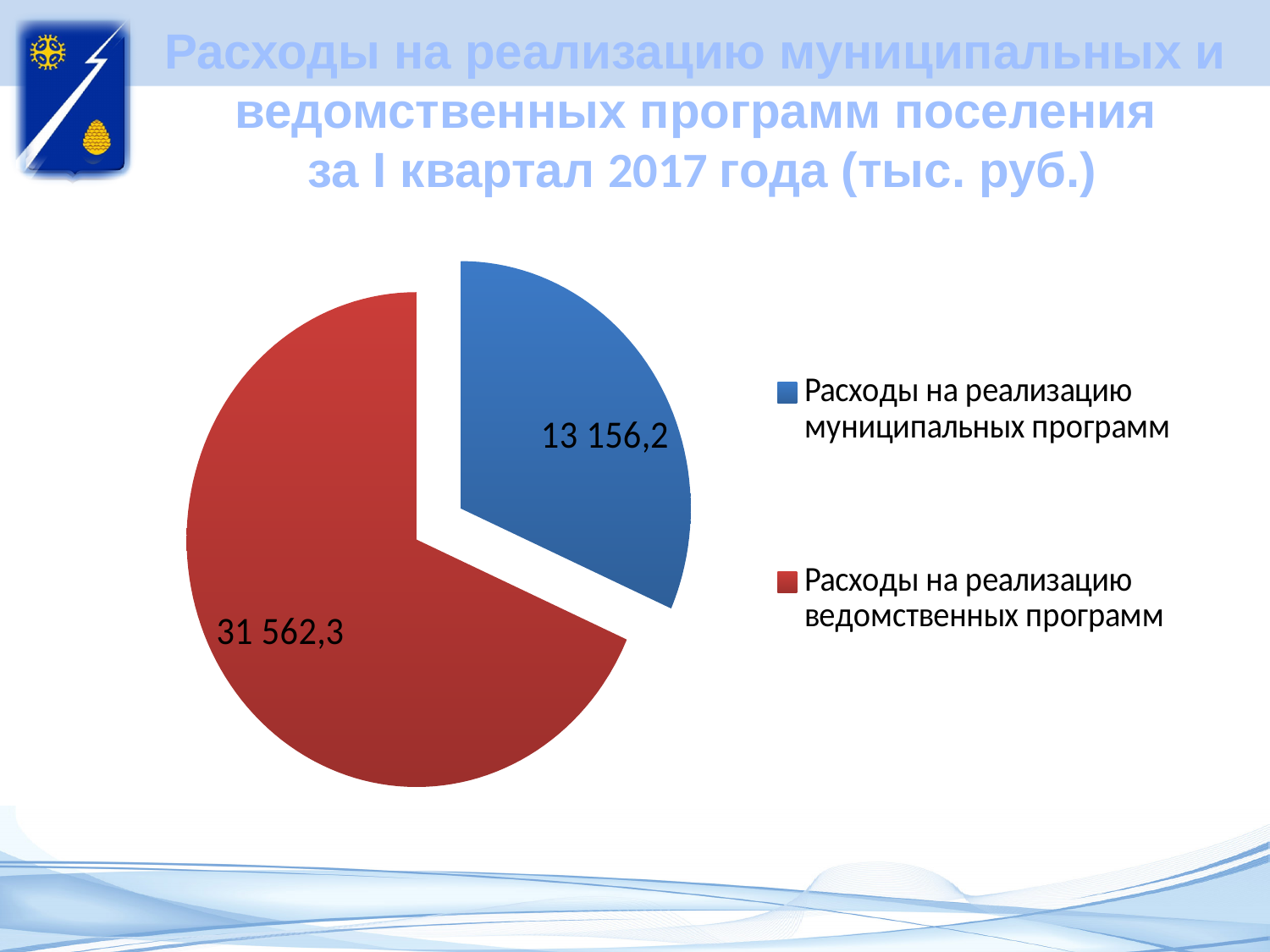
What is the difference between the value for ведомственных программ and the value for муниципальных программ? 18 406,1 How many slices does the pie chart have? 2 What share of the pie does Расходы на реализацию ведомственных программ represent, to the nearest whole percent? 71% How many entries does the legend list? 2 Which category has the smallest slice of the pie? Расходы на реализацию муниципальных программ What is the total of the two values shown in the pie chart? 44 718,5 What type of chart is shown on the slide? Pie chart What colour is the slice for Расходы на реализацию муниципальных программ? Blue What is the value for Расходы на реализацию муниципальных программ? 13 156,2 Which is larger: the value for муниципальных программ or the value for ведомственных программ? Расходы на реализацию ведомственных программ What is the value for Расходы на реализацию ведомственных программ? 31 562,3 Which category has the largest slice of the pie? Расходы на реализацию ведомственных программ